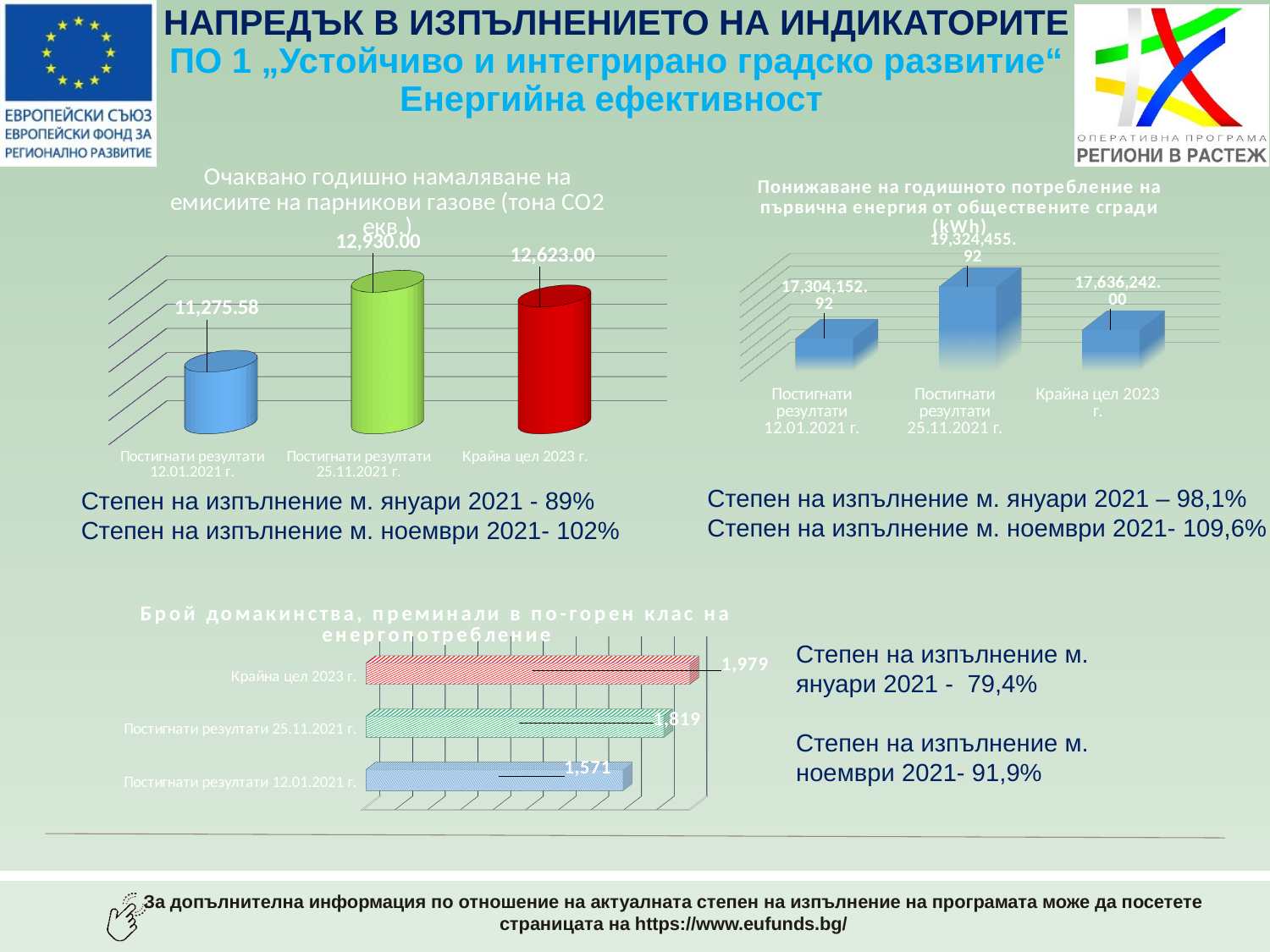
In the chart 'Брой домакинства, преминали в по-горен клас на енергопотребление', which is larger: 'Постигнати резултати 25.11.2021 г.' or 'Постигнати резултати 12.01.2021 г.'? Постигнати резултати 25.11.2021 г. How many charts are shown on the slide? 3 In the chart 'Очаквано годишно намаляване на емисиите на парникови газове', which category has the highest value? Постигнати резултати 25.11.2021 г. In the chart 'Очаквано годишно намаляване на емисиите на парникови газове', what is the value for 'Постигнати резултати 12.01.2021 г.'? 11,275.58 What type of chart is 'Брой домакинства, преминали в по-горен клас на енергопотребление'? Bar chart In the chart 'Понижаване на годишното потребление на първична енергия от обществените сгради (kWh)', what is the value for 'Постигнати резултати 25.11.2021 г.'? 19,324,455.92 In the chart 'Понижаване на годишното потребление на първична енергия от обществените сгради (kWh)', what is the difference between 'Постигнати резултати 25.11.2021 г.' and 'Постигнати резултати 12.01.2021 г.'? 2,020,303.00 In the chart 'Брой домакинства, преминали в по-горен клас на енергопотребление', what is the value for 'Крайна цел 2023 г.'? 1,979 In the chart 'Очаквано годишно намаляване на емисиите на парникови газове', how many bars are shown? 3 In the chart 'Очаквано годишно намаляване на емисиите на парникови газове', what is the difference between 'Постигнати резултати 25.11.2021 г.' and 'Крайна цел 2023 г.'? 307.00 In the chart 'Понижаване на годишното потребление на първична енергия от обществените сгради (kWh)', which category has the lowest value? Постигнати резултати 12.01.2021 г. In the chart 'Брой домакинства, преминали в по-горен клас на енергопотребление', what is the difference between 'Крайна цел 2023 г.' and 'Постигнати резултати 12.01.2021 г.'? 408